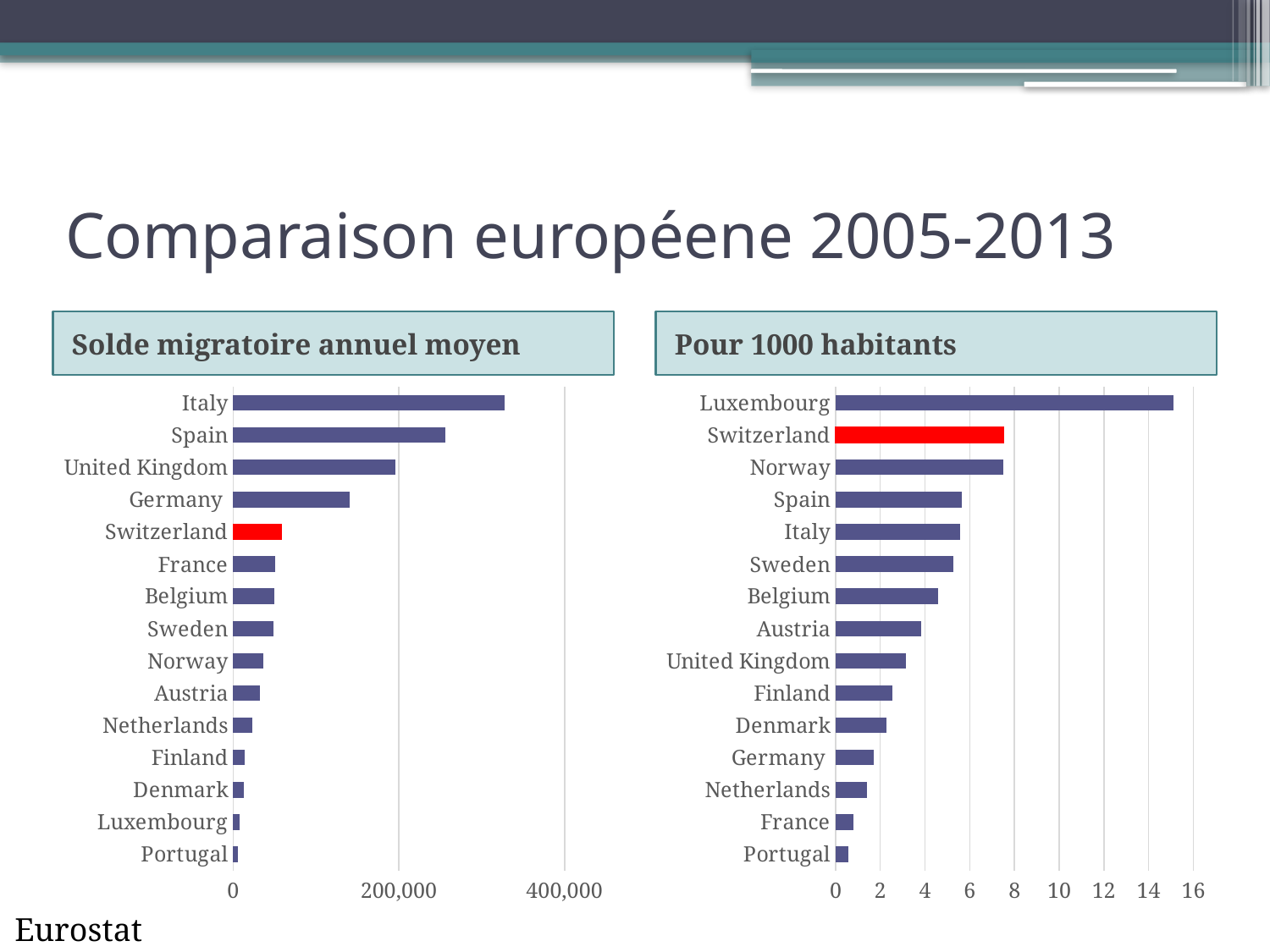
How many countries are shown in the 'Solde migratoire annuel moyen' chart? 15 In the 'Pour 1000 habitants' chart, which country has the lowest value? Portugal In the 'Solde migratoire annuel moyen' chart, is the value for Germany greater or less than 200,000? less In the 'Solde migratoire annuel moyen' chart, is the value for Spain greater or less than 200,000? greater In the 'Solde migratoire annuel moyen' chart, which is larger, Germany or Switzerland? Germany In the 'Pour 1000 habitants' chart, is the value for Luxembourg greater or less than 14? greater In the 'Pour 1000 habitants' chart, which country has the highest value? Luxembourg In the 'Solde migratoire annuel moyen' chart, which country has the highest value? Italy In the 'Solde migratoire annuel moyen' chart, which country has the lowest value? Portugal What kind of chart is the 'Solde migratoire annuel moyen' chart? Bar chart In the 'Pour 1000 habitants' chart, which country's bar is coloured red? Switzerland